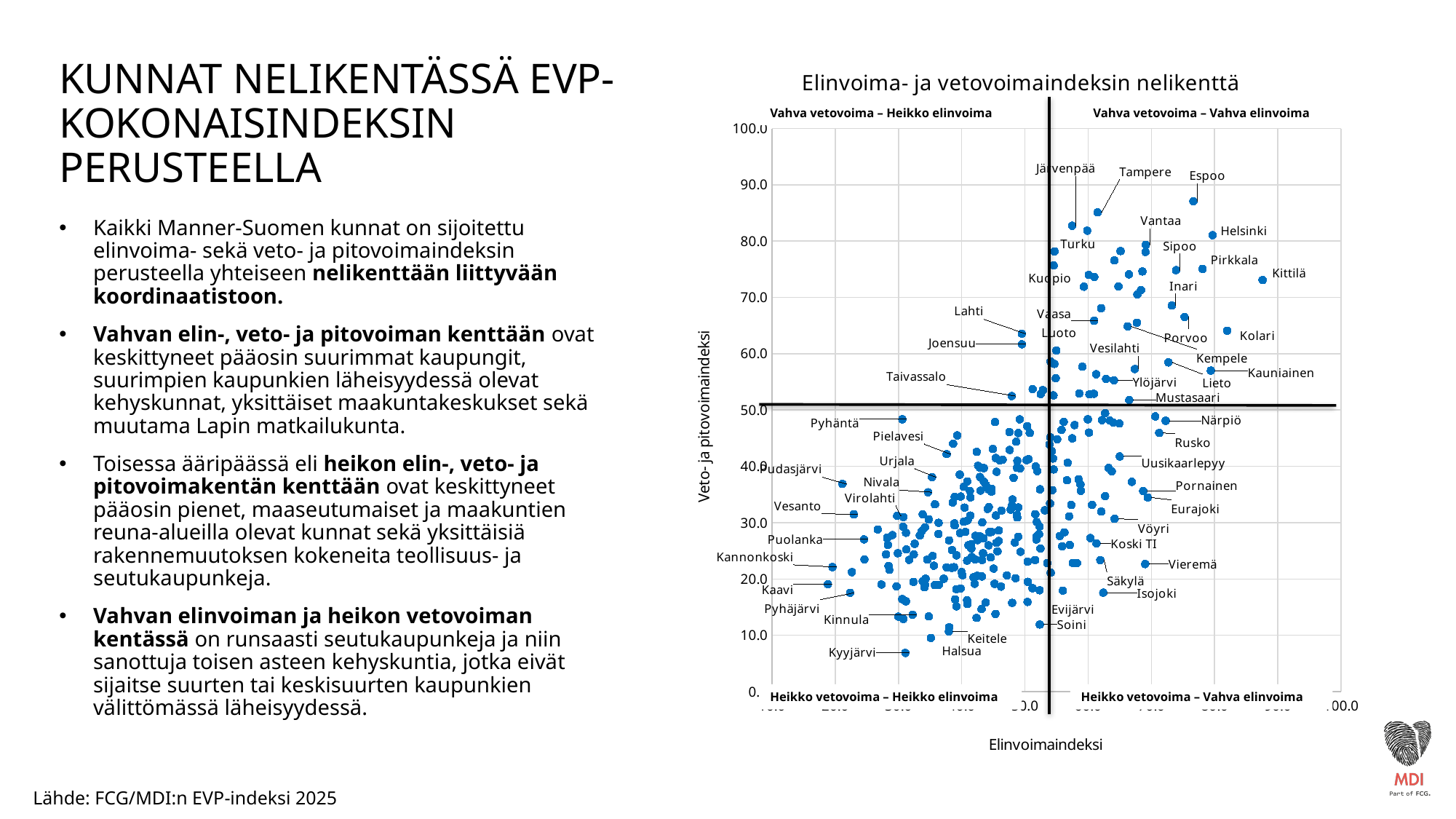
Which labeled municipality has the lowest Veto- ja pitovoimaindeksi value on the chart? Kyyjärvi Is the Veto- ja pitovoimaindeksi value for Espoo greater or less than 80? greater Is the Veto- ja pitovoimaindeksi value for Kittilä greater or less than 70? greater Is the Veto- ja pitovoimaindeksi value for Puolanka greater or less than 30? less What is the label of the vertical axis of the chart? Veto- ja pitovoimaindeksi What kind of chart is shown on the slide? Scatter plot Which labeled municipality has the highest Elinvoimaindeksi value (furthest right) on the chart? Kittilä Which has a higher Veto- ja pitovoimaindeksi value, Espoo or Kyyjärvi? Espoo What is the title of the chart? Elinvoima- ja vetovoimaindeksin nelikenttä